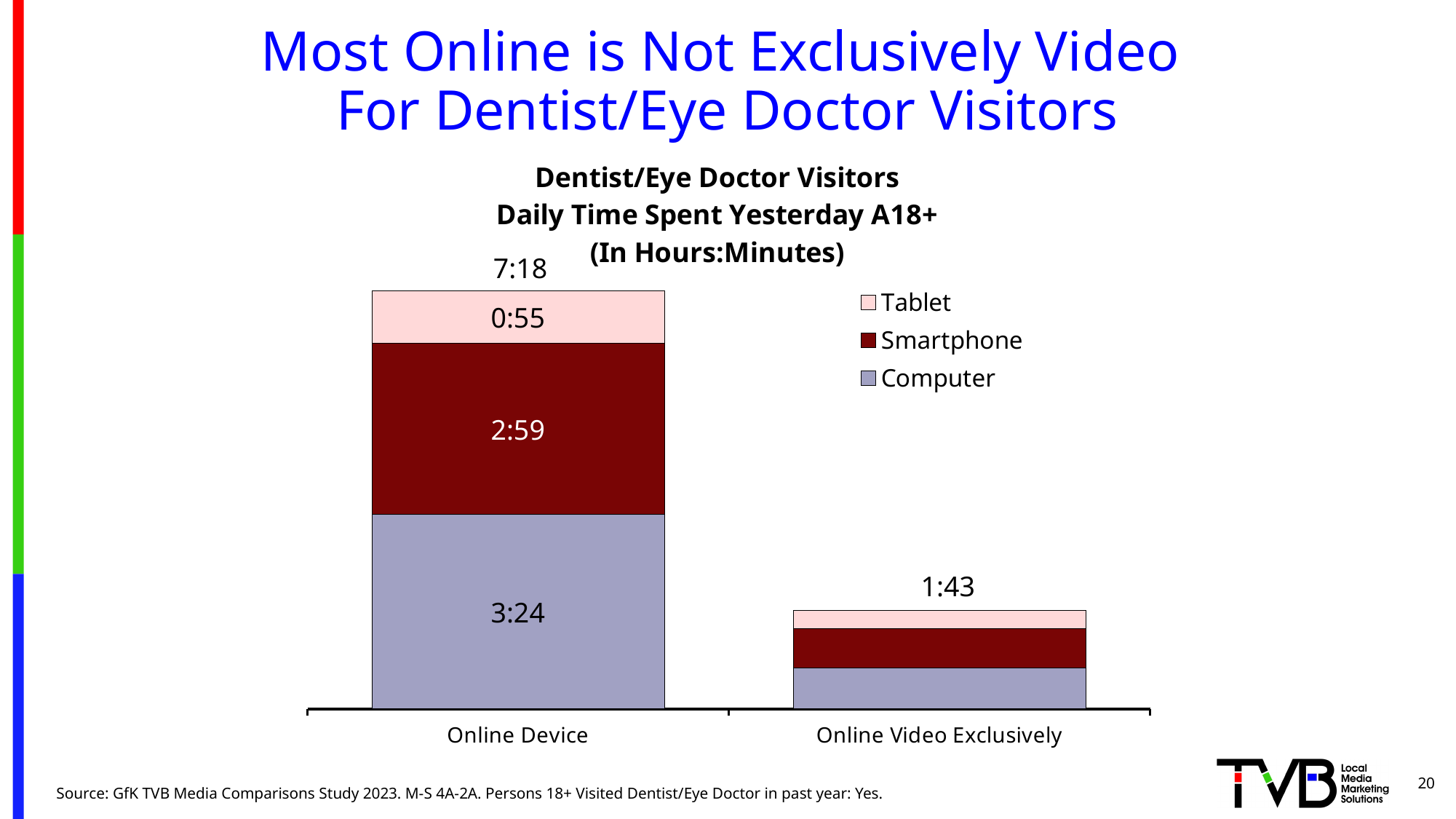
Which device segment is the smallest within the Online Device bar? Tablet Which device segment is the largest within the Online Device bar? Computer What is the Tablet value for Online Device? 0:55 What is the total daily time spent for Online Device? 7:18 What is the Computer value for Online Device? 3:24 What is the Smartphone value for Online Device? 2:59 What is the total daily time spent for Online Video Exclusively? 1:43 How many categories are shown on the x axis? 2 How many series does the legend list? 3 What kind of chart is shown? Stacked bar chart Which series is shown in dark red? Smartphone Which category has the higher total, Online Device or Online Video Exclusively? Online Device